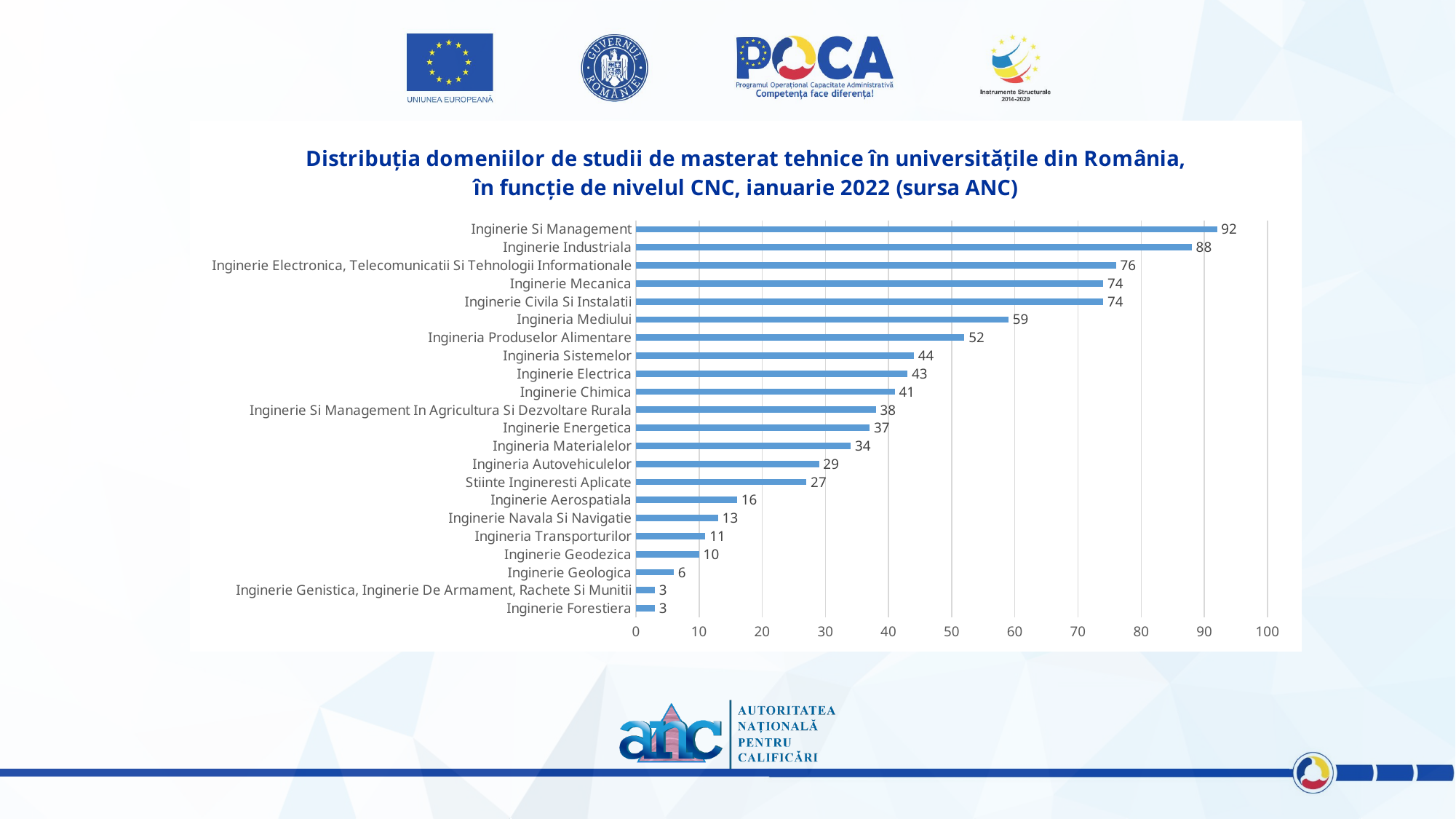
What is the value for Inginerie Aerospatiala? 16 Which category has the highest value? Inginerie Si Management What is the value for Ingineria Mediului? 59 What is the value for Inginerie Geologica? 6 Which is larger, Ingineria Produselor Alimentare or Ingineria Sistemelor? Ingineria Produselor Alimentare What is the difference between Inginerie Si Management and Inginerie Industriala? 4 What kind of chart is shown on the slide? Bar chart Is the value for Inginerie Mecanica greater or less than 70? greater How many categories are shown in the chart? 22 What is the difference between Ingineria Materialelor and Ingineria Autovehiculelor? 5 What is the value for Inginerie Industriala? 88 What is the maximum value shown on the x axis? 100